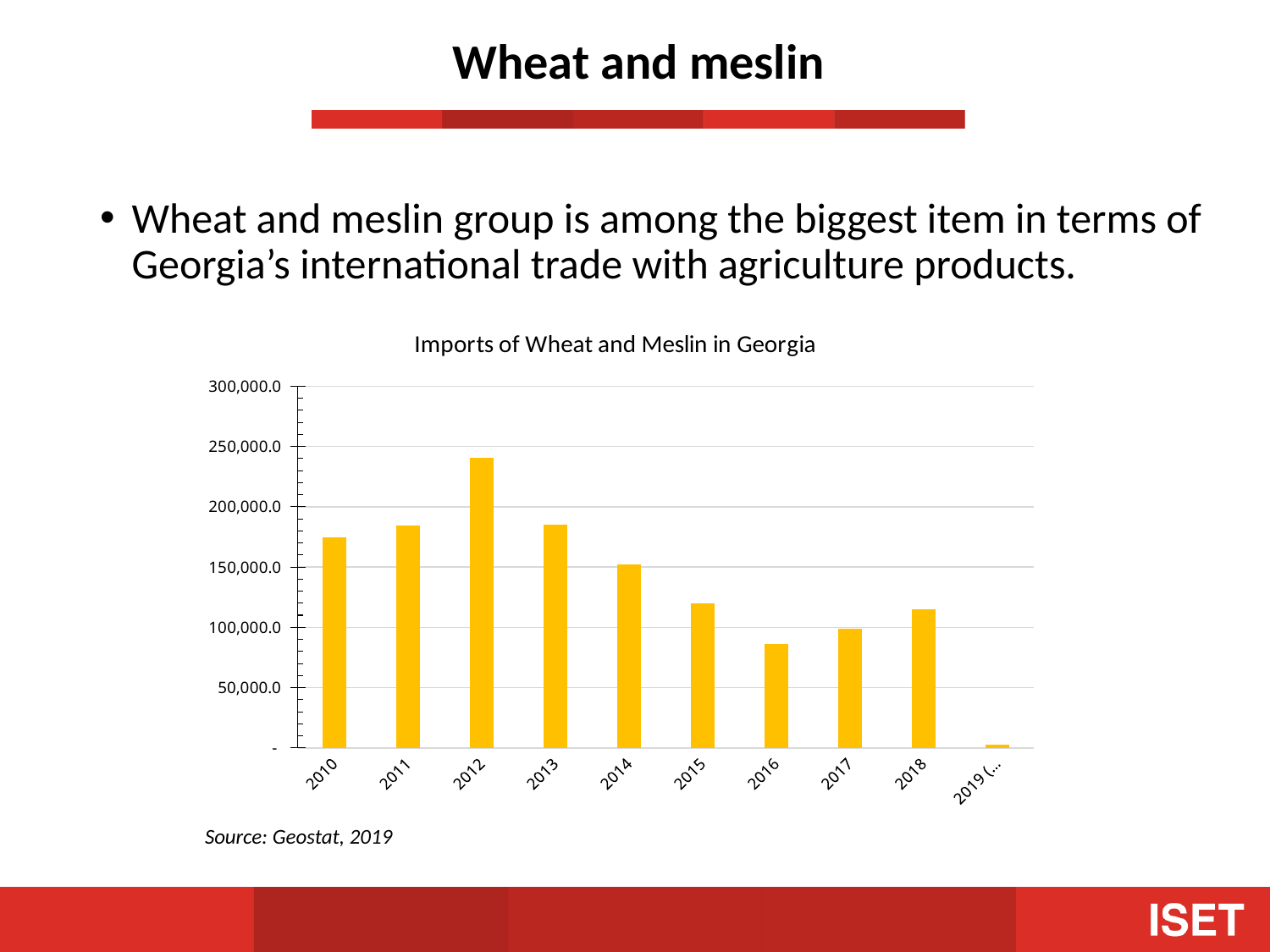
Which year has the larger value, 2016 or 2018? 2018 Do the values rise or fall from 2012 to 2016? fall Is the value for 2012 greater or less than 200,000.0? greater What kind of chart is shown on the slide? bar chart Which year has the highest imports of wheat and meslin? 2012 Among the years 2010 to 2018, which year has the lowest imports of wheat and meslin? 2016 Which year has the larger value, 2012 or 2013? 2012 What is the title of the chart? Imports of Wheat and Meslin in Georgia How many bars (years) are plotted in the chart? 10 Is the value for 2016 greater or less than 100,000.0? less Is the value for 2010 greater or less than 150,000.0? greater